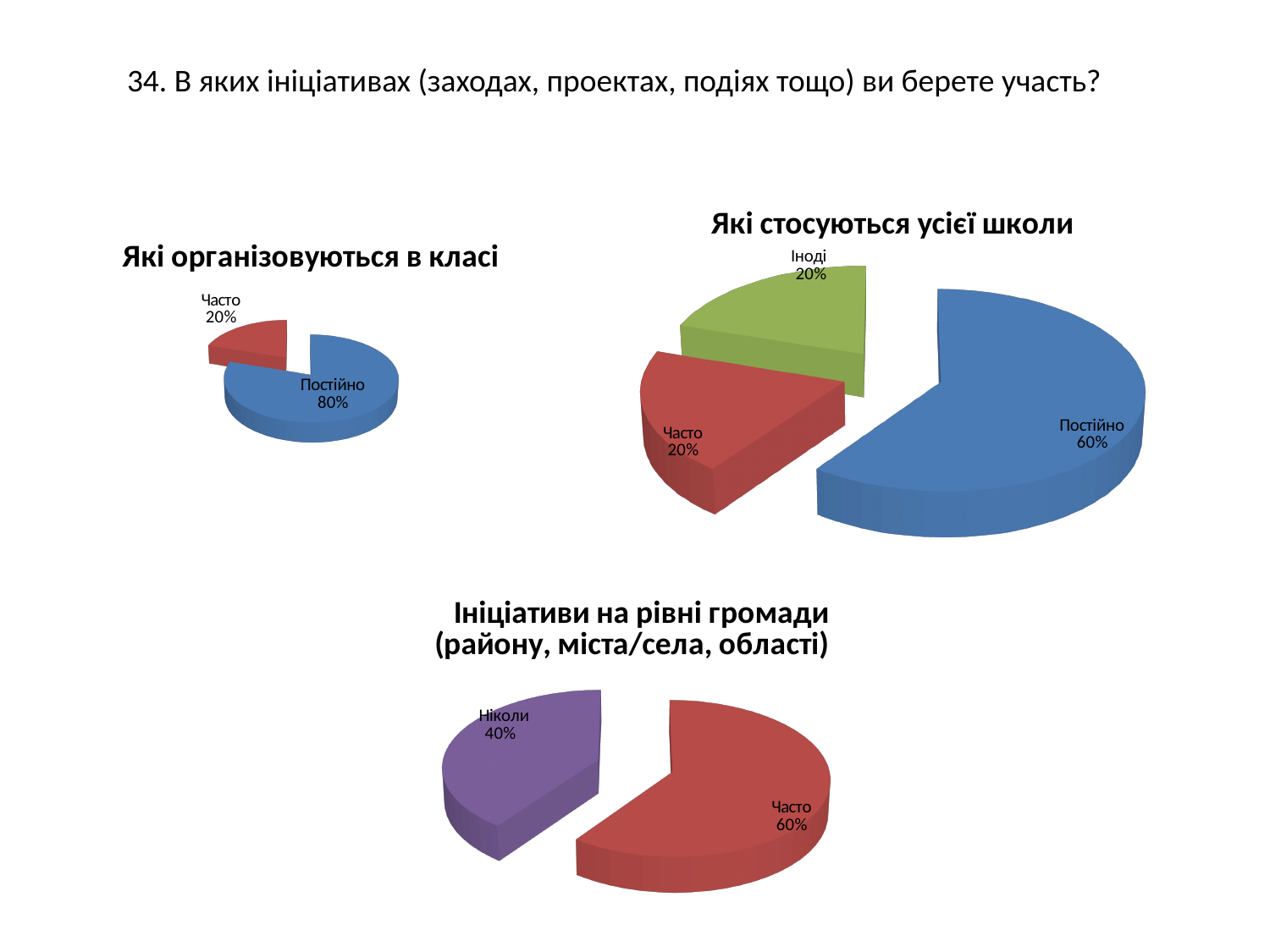
How many slices does the chart titled "Які стосуються усієї школи" have? 3 In the chart titled "Які стосуються усієї школи", what is the share for "Постійно"? 60% In the chart titled "Ініціативи на рівні громади (району, міста/села, області)", which category has the largest share? Часто In the chart titled "Ініціативи на рівні громади (району, міста/села, області)", what is the share for "Ніколи"? 40% In the chart titled "Які організовуються в класі", what is the difference between the shares for "Постійно" and "Часто"? 60% What kind of chart is the chart titled "Які організовуються в класі"? Pie chart In the chart titled "Які організовуються в класі", what is the share for "Часто"? 20% In the chart titled "Які стосуються усієї школи", which category has the largest share? Постійно In the chart titled "Які організовуються в класі", what is the share for "Постійно"? 80% How many charts are shown on the slide? 3 In the chart titled "Які стосуються усієї школи", what is the share for "Іноді"? 20% In the chart titled "Ініціативи на рівні громади (району, міста/села, області)", which is larger: "Часто" or "Ніколи"? Часто